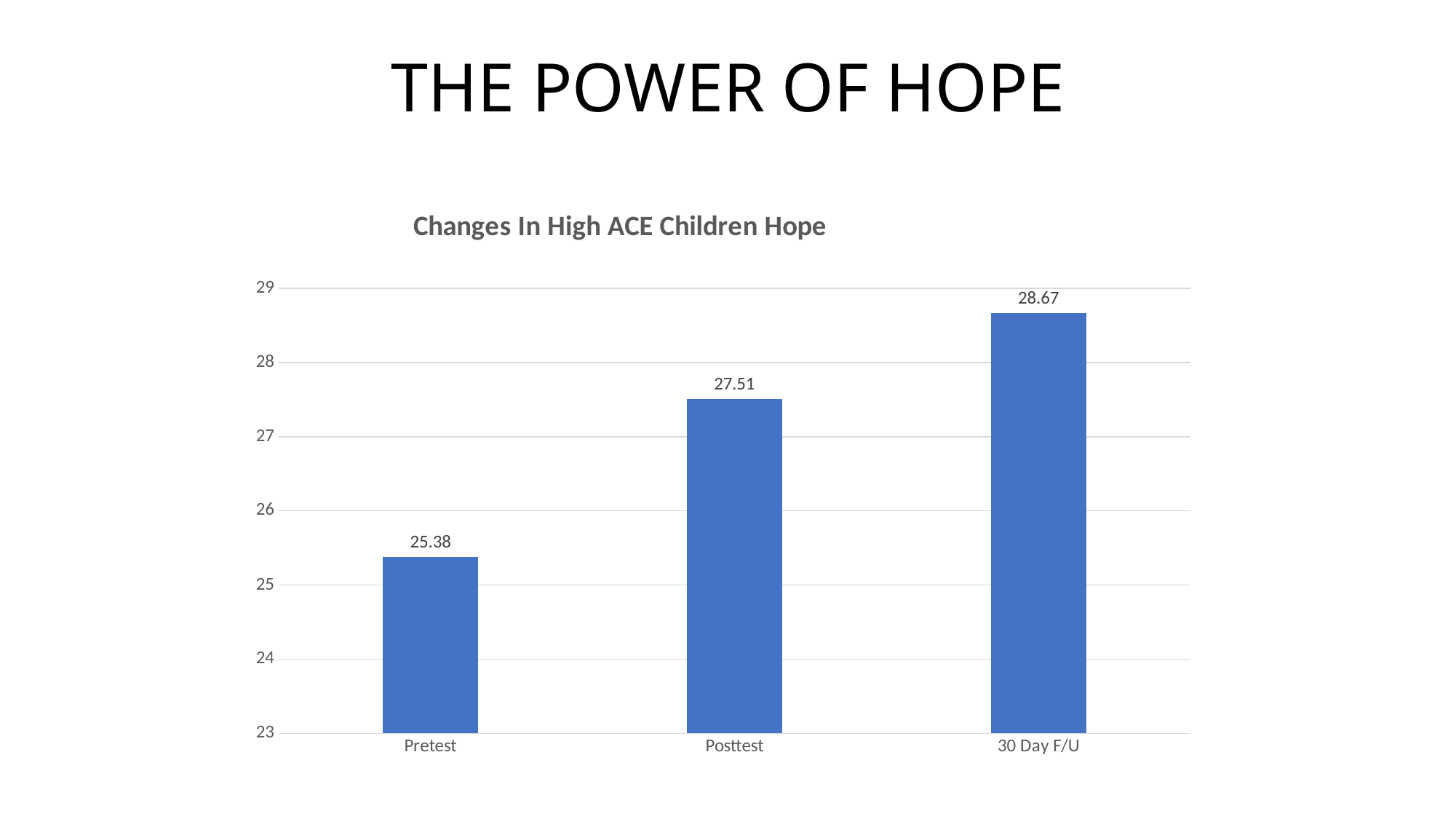
Which category has the highest value? 30 Day F/U What is the value for Pretest? 25.38 Do the values rise or fall from Pretest to 30 Day F/U? rise What is the value for 30 Day F/U? 28.67 What is the value for Posttest? 27.51 How many categories are shown on the x axis? 3 Which category has the lowest value? Pretest Is the value for Posttest greater or less than 27? greater What kind of chart is shown on the slide? bar chart What is the difference between the Posttest value and the Pretest value? 2.13 What is the difference between the 30 Day F/U value and the Pretest value? 3.29 Which is larger, the value for Posttest or the value for 30 Day F/U? 30 Day F/U